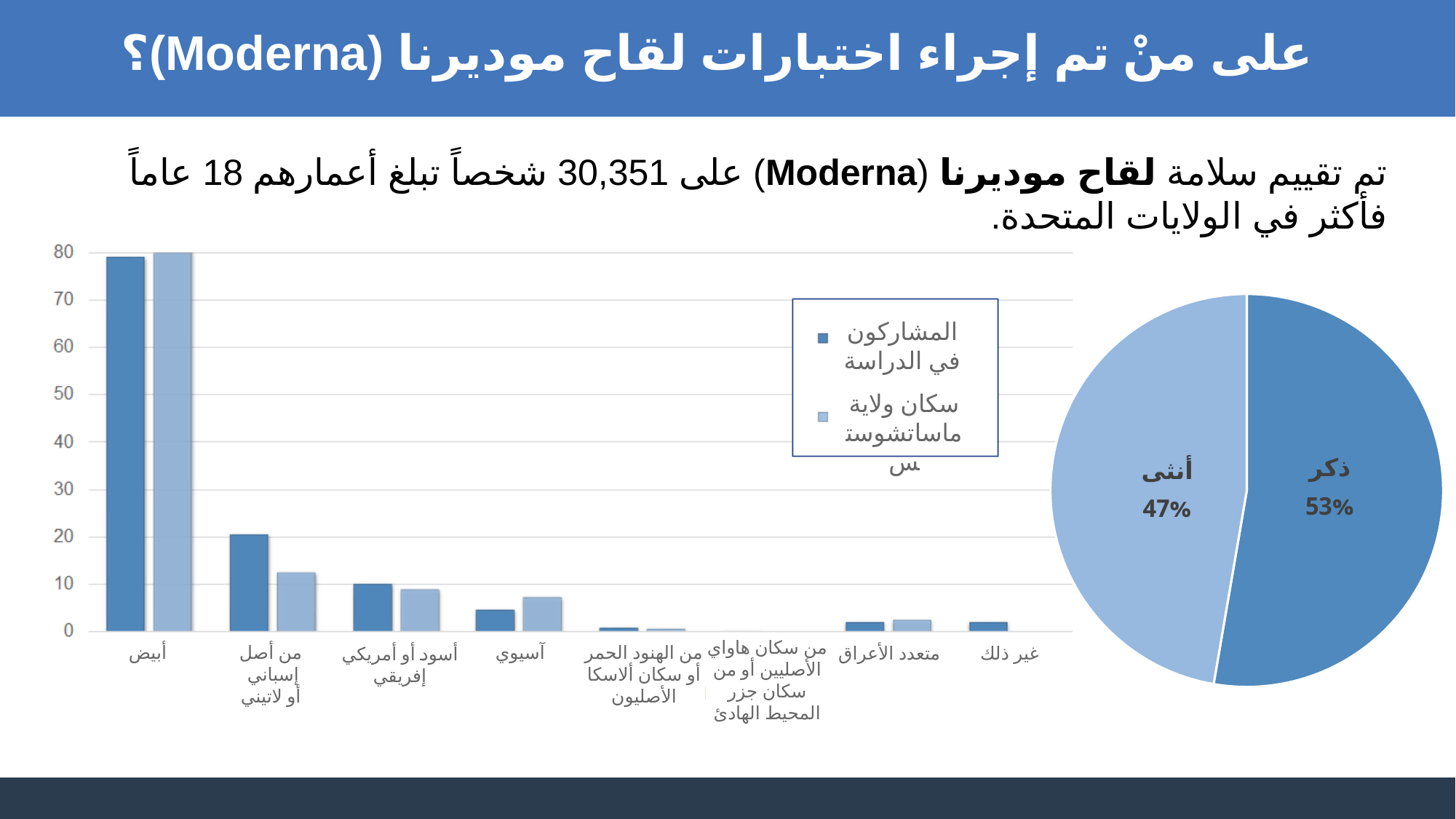
In the bar chart on the left, which category has the highest value for المشاركون في الدراسة? أبيض In the pie chart on the right, what is the difference between the shares of ذكر and أنثى? 6% In the bar chart on the left, how many series does the legend list? 2 In the pie chart on the right, what share does ذكر have? 53% In the bar chart on the left, how many categories are shown on the x axis? 8 In the bar chart on the left, is the value for من أصل إسباني أو لاتيني in the series سكان ولاية ماساتشوستس greater or less than 10? greater In the bar chart on the left, for the category آسيوي, which series has the larger value? سكان ولاية ماساتشوستس What kind of chart is the chart on the left of the slide? bar chart In the bar chart on the left, is the value for آسيوي in the series المشاركون في الدراسة greater or less than 10? less In the bar chart on the left, for the category من أصل إسباني أو لاتيني, which series has the larger value? المشاركون في الدراسة In the bar chart on the left, is the value for أبيض in the series المشاركون في الدراسة greater or less than 70? greater What kind of chart is the chart on the right of the slide? pie chart